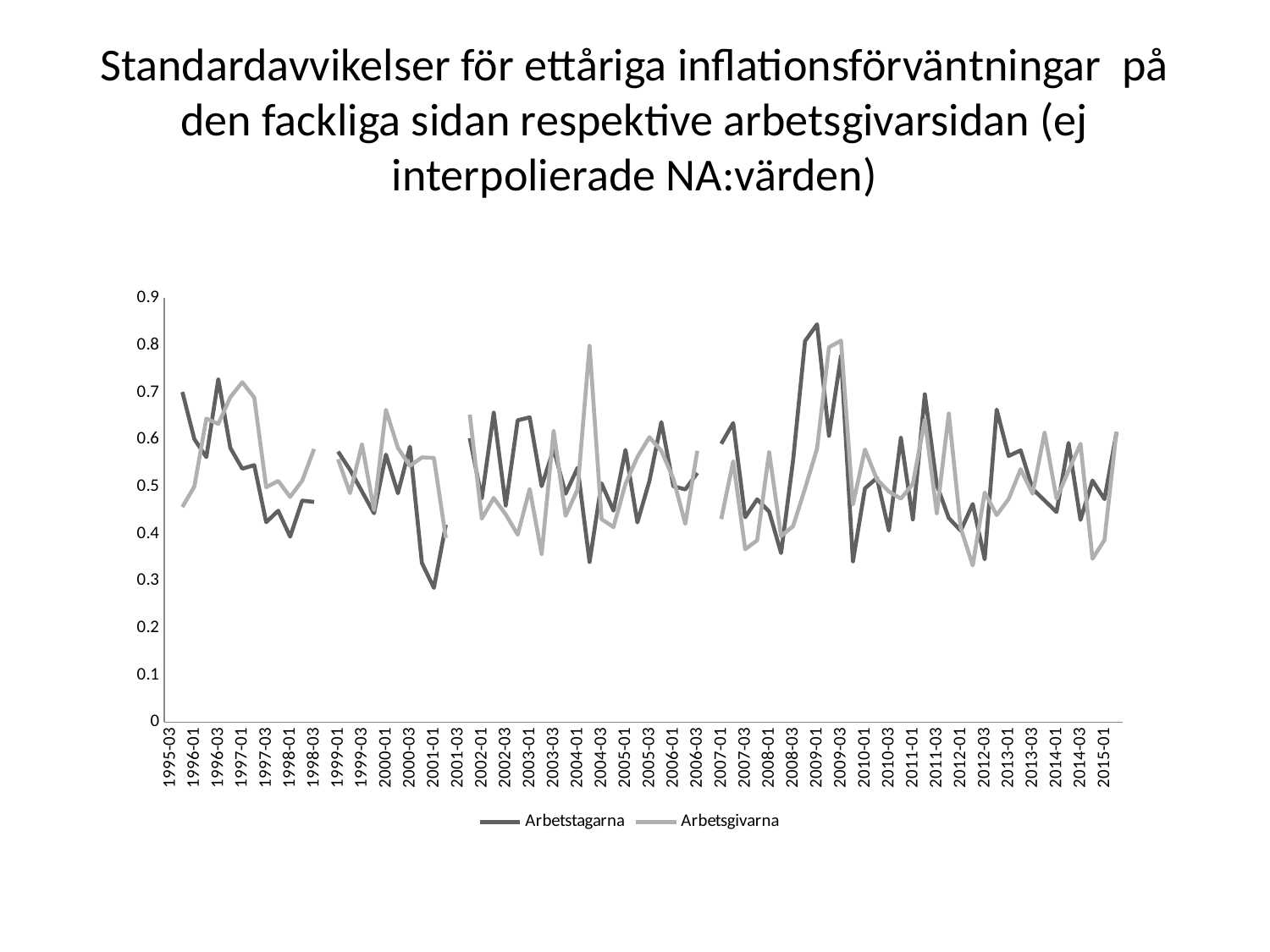
Is the value for Arbetstagarna at 1996-03 greater or less than 0.6? greater At 2009-01, which series has the larger value, Arbetstagarna or Arbetsgivarna? Arbetstagarna Is the value for Arbetstagarna at 2001-01 greater or less than 0.4? less Is the value for Arbetstagarna at 2009-01 greater or less than 0.7? greater How many series does the legend list? 2 Which series is drawn with the darker line? Arbetstagarna What kind of chart is shown on the slide? line chart What are the two series named in the legend? Arbetstagarna and Arbetsgivarna At 2001-01, which series has the larger value, Arbetstagarna or Arbetsgivarna? Arbetsgivarna